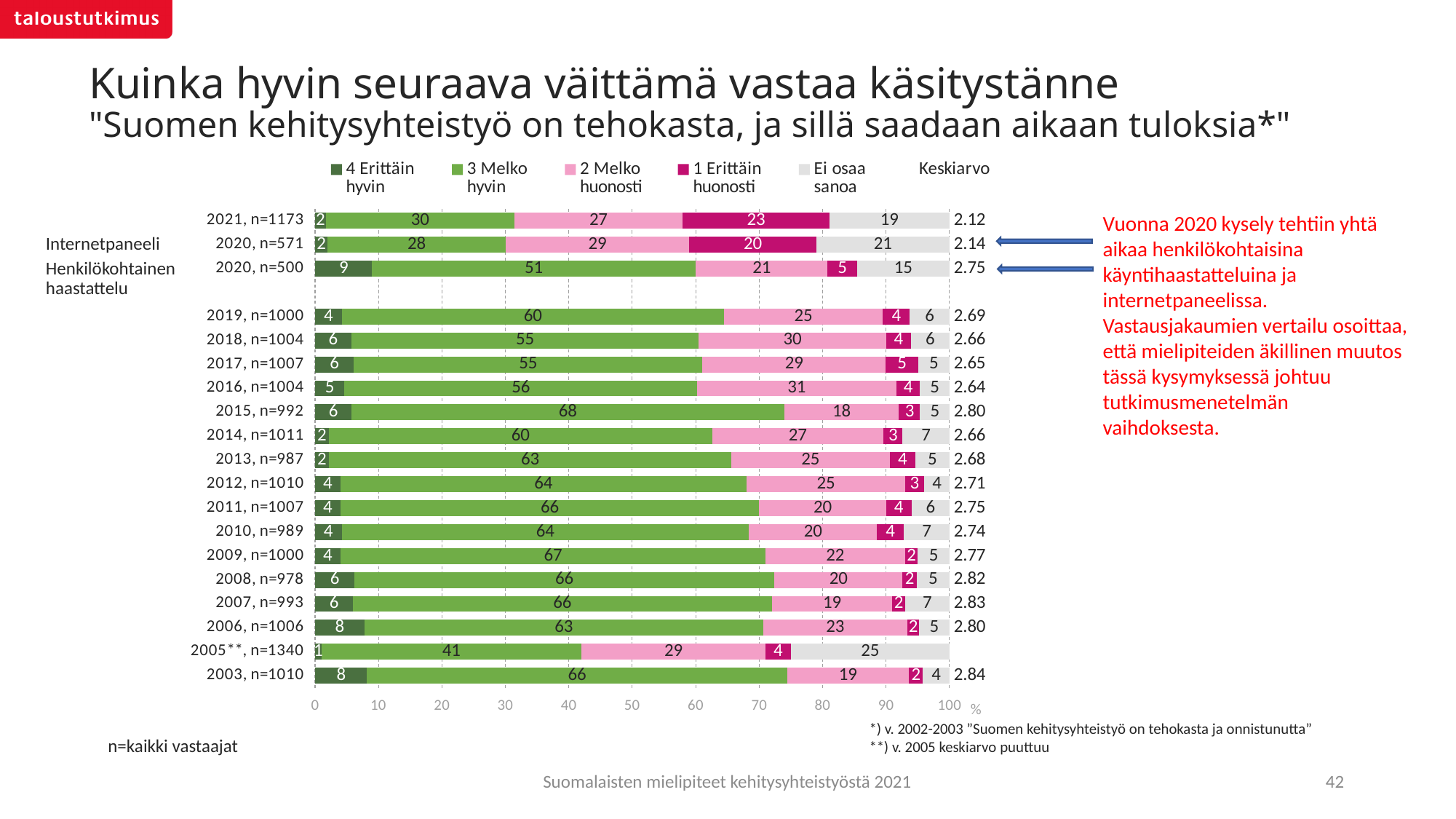
What is the value for "1 Erittäin huonosti" in the 2021, n=1173 bar? 23 Which bar has the highest value for "3 Melko hyvin"? 2015, n=992 What is the Keskiarvo shown for 2020, n=500? 2.75 What is the difference between the "Ei osaa sanoa" values for 2020, n=571 and 2020, n=500? 6 Which has a larger "2 Melko huonosti" value: 2016, n=1004 or 2018, n=1004? 2016, n=1004 Which bar has the highest "Ei osaa sanoa" value? 2005**, n=1340 What is the value for "3 Melko hyvin" in the 2015, n=992 bar? 68 What is the Keskiarvo shown for 2003, n=1010? 2.84 What kind of chart is shown on the slide? Stacked bar chart What is the total of the printed segment values in the 2020, n=571 bar? 100 Which bar has the lowest Keskiarvo value? 2021, n=1173 What is the value for "4 Erittäin hyvin" in the 2006, n=1006 bar? 8